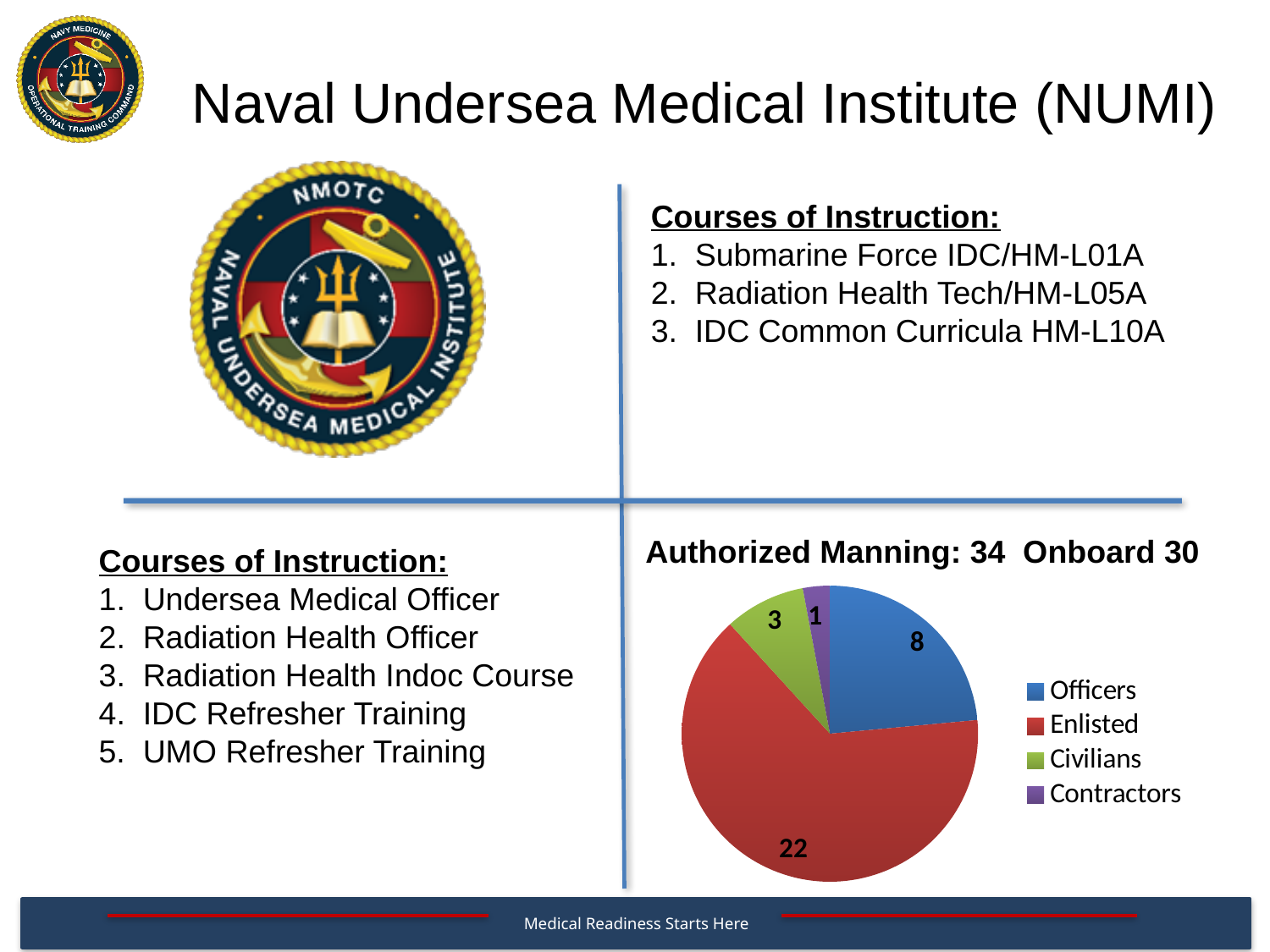
Which colour represents Enlisted in the pie chart? red Which is larger in the pie chart, Officers or Civilians? Officers What kind of chart is shown on the slide? pie chart How many slices does the pie chart have? 4 Which category has the largest slice in the pie chart? Enlisted What is the value for Contractors in the pie chart? 1 Which category has the smallest slice in the pie chart? Contractors What is the value for Enlisted in the pie chart? 22 What is the difference between the Enlisted and Officers values in the pie chart? 14 What is the value for Civilians in the pie chart? 3 How many entries does the pie chart's legend list? 4 What is the value for Officers in the pie chart? 8